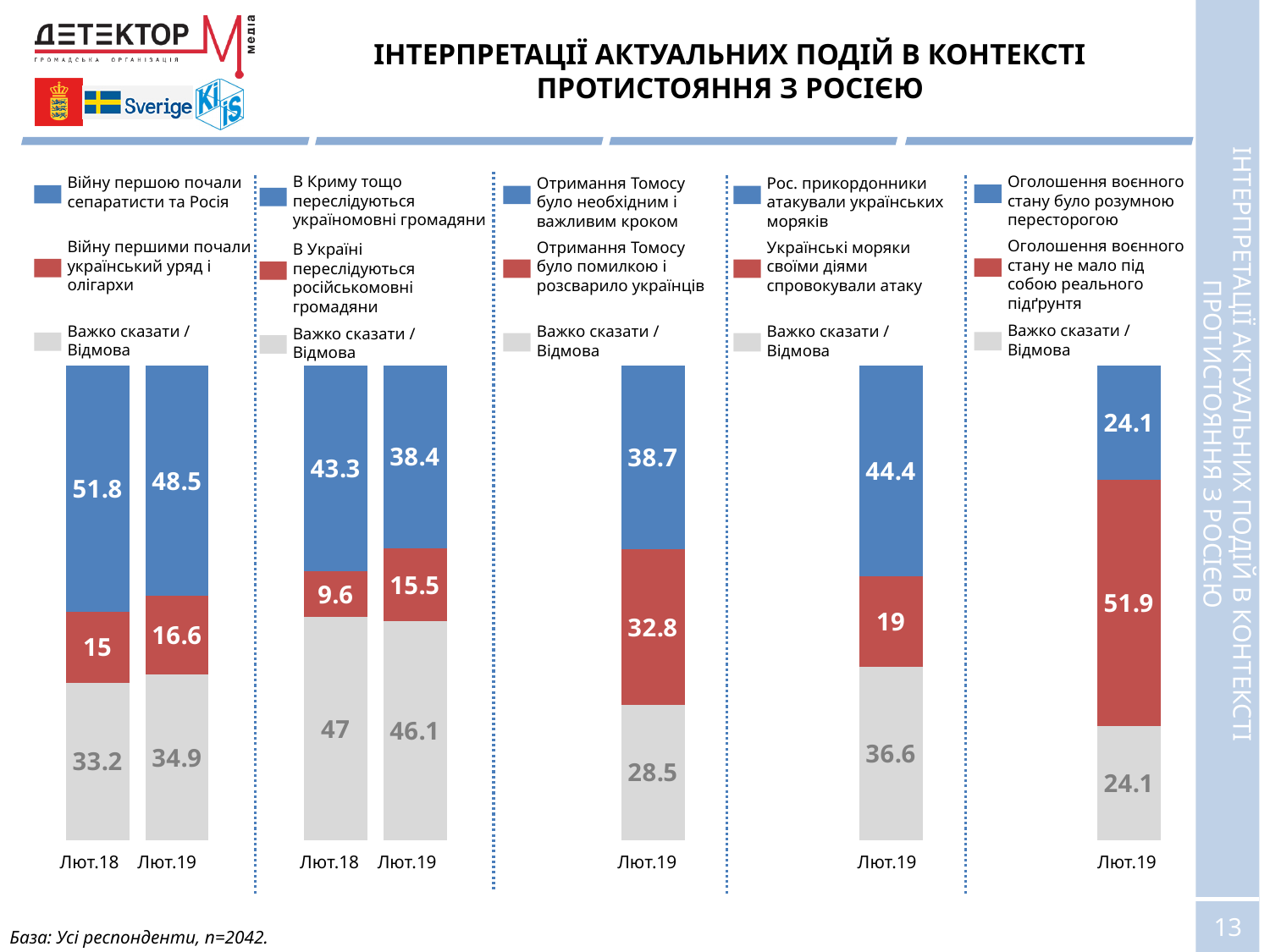
In the fourth chart from the left, which is larger: 'Рос. прикордонники атакували українських моряків' or 'Важко сказати / Відмова'? Рос. прикордонники атакували українських моряків In the second chart from the left, what is the difference between the 'Важко сказати / Відмова' values for Лют.18 and Лют.19? 0.9 In the middle chart (Tomos), what is the value for 'Отримання Томосу було помилкою і розсварило українців'? 32.8 In the rightmost chart (martial law), what is the value for 'Оголошення воєнного стану не мало під собою реального підґрунтя'? 51.9 What kind of chart is the middle chart (Tomos)? Stacked bar chart In the second chart from the left (persecution in Crimea), what is the value for 'В Україні переслідуються російськомовні громадяни' in Лют.19? 15.5 In the leftmost chart, what is the value for 'Важко сказати / Відмова' in Лют.19? 34.9 In the fourth chart from the left (Russian border guards), what is the value for 'Українські моряки своїми діями спровокували атаку'? 19 In the middle chart (Tomos), which segment is the largest? Отримання Томосу було необхідним і важливим кроком How many series does the legend of the leftmost chart list? 3 In the leftmost chart (war started by separatists and Russia), what is the value for 'Війну першою почали сепаратисти та Росія' in Лют.18? 51.8 In the rightmost chart, what is the total of the stacked bar for Лют.19? 100.1